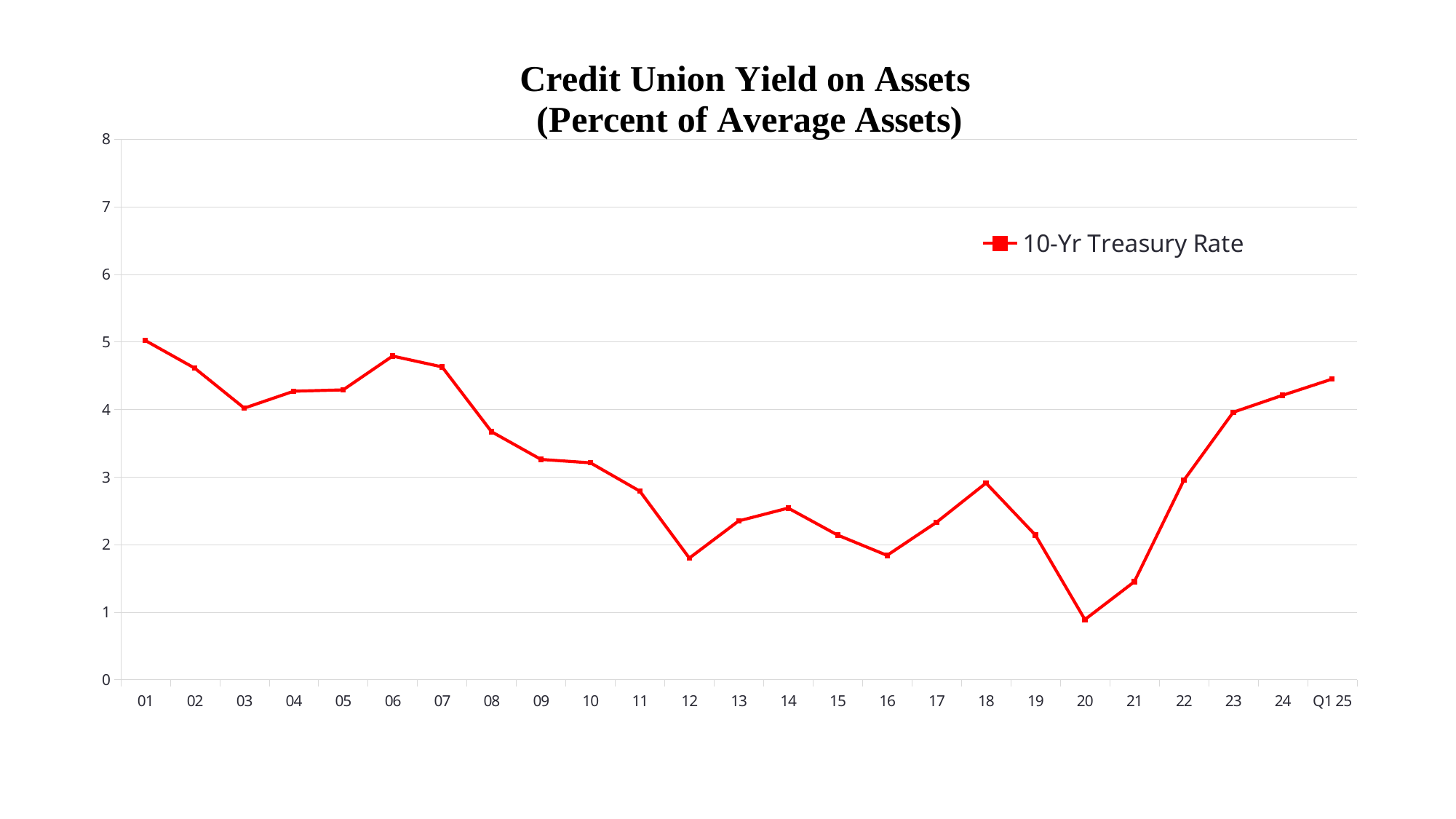
Do the values rise or fall from 20 to Q1 25? rise Which year has the highest 10-Yr Treasury Rate? 01 Is the value for 12 greater or less than 2? less What is the name of the series shown in the legend? 10-Yr Treasury Rate Which is larger, the value for 06 or the value for 07? 06 What kind of chart is shown on the slide? line chart Is the value for 06 greater or less than 4? greater Which year has the lowest 10-Yr Treasury Rate? 20 Is the value for Q1 25 greater or less than 4? greater How many series does the legend list? 1 How many points are plotted along the x axis? 25